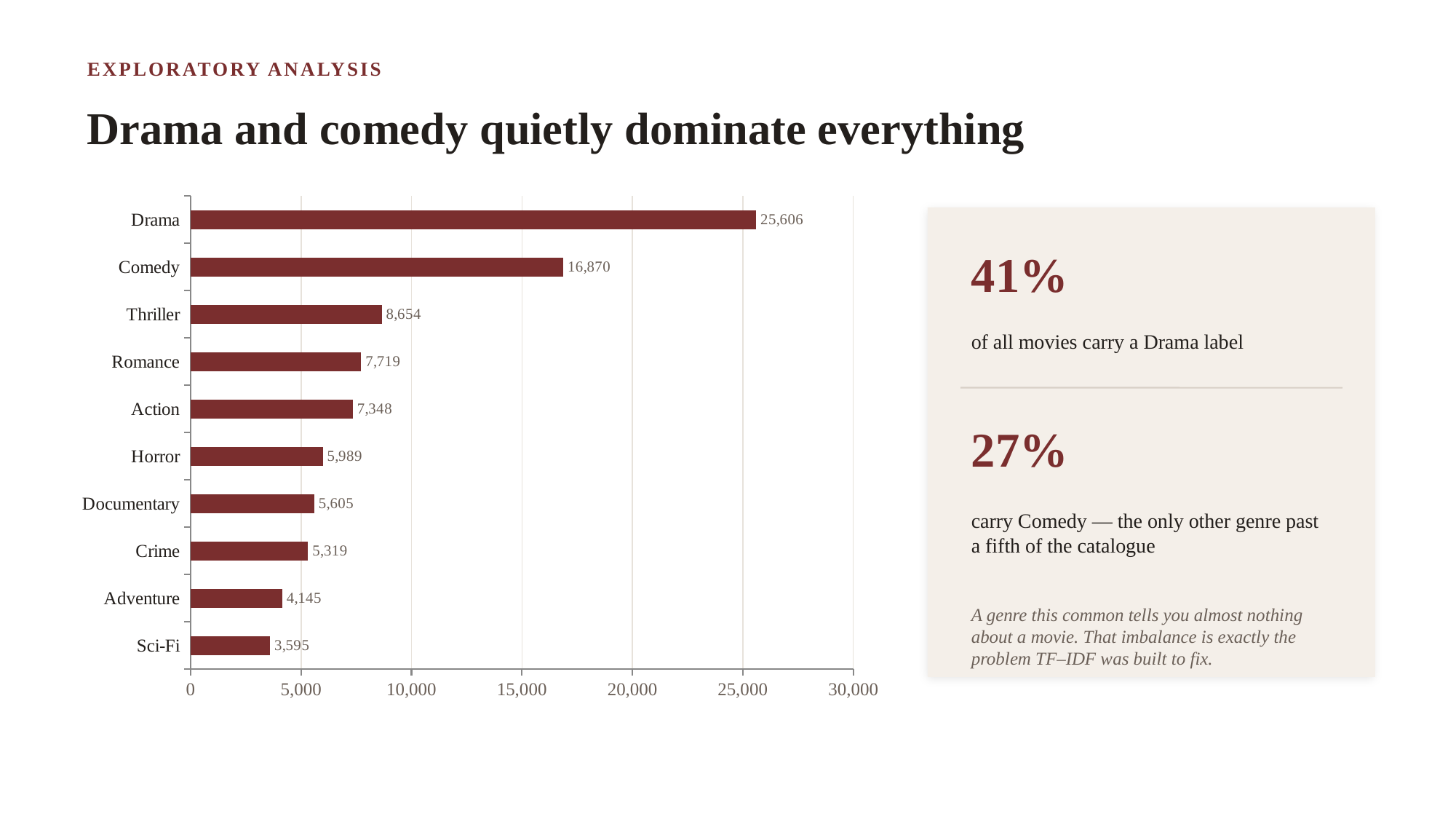
What kind of chart is shown on the slide? bar chart What is the value for Drama? 25,606 What is the difference between the values for Adventure and Sci-Fi? 550 What is the value for Thriller? 8,654 Which genre has the lowest value? Sci-Fi What is the difference between the values for Drama and Comedy? 8,736 What is the value for Documentary? 5,605 What is the maximum value shown on the horizontal axis? 30,000 Is the value for Comedy greater or less than 15,000? greater Which is larger, the value for Romance or the value for Action? Romance How many genres are shown in the chart? 10 Which genre has the highest value? Drama